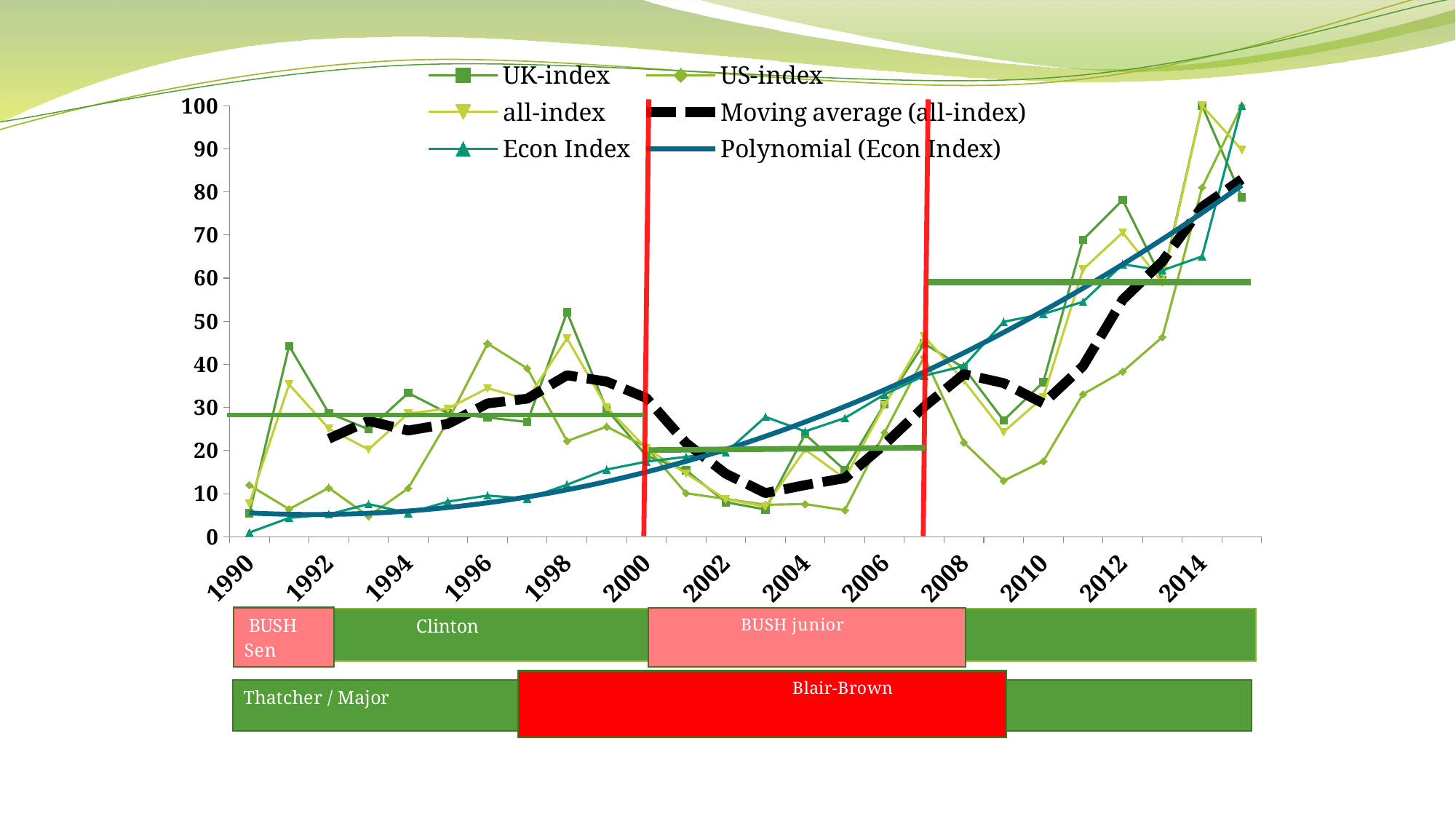
In 1991, which is larger: the UK-index or the US-index? UK-index Is the value of the all-index in 2014 greater or less than 90? greater Is the value of the US-index in 2009 greater or less than 20? less Which series is drawn as a thick black dashed line? Moving average (all-index) How many year labels are shown on the x axis? 13 What kind of chart is shown on the slide? line chart How many series does the legend list? 6 Does the Polynomial (Econ Index) line rise or fall from 1990 to 2014? rise Is the value of the UK-index in 2012 greater or less than 70? greater